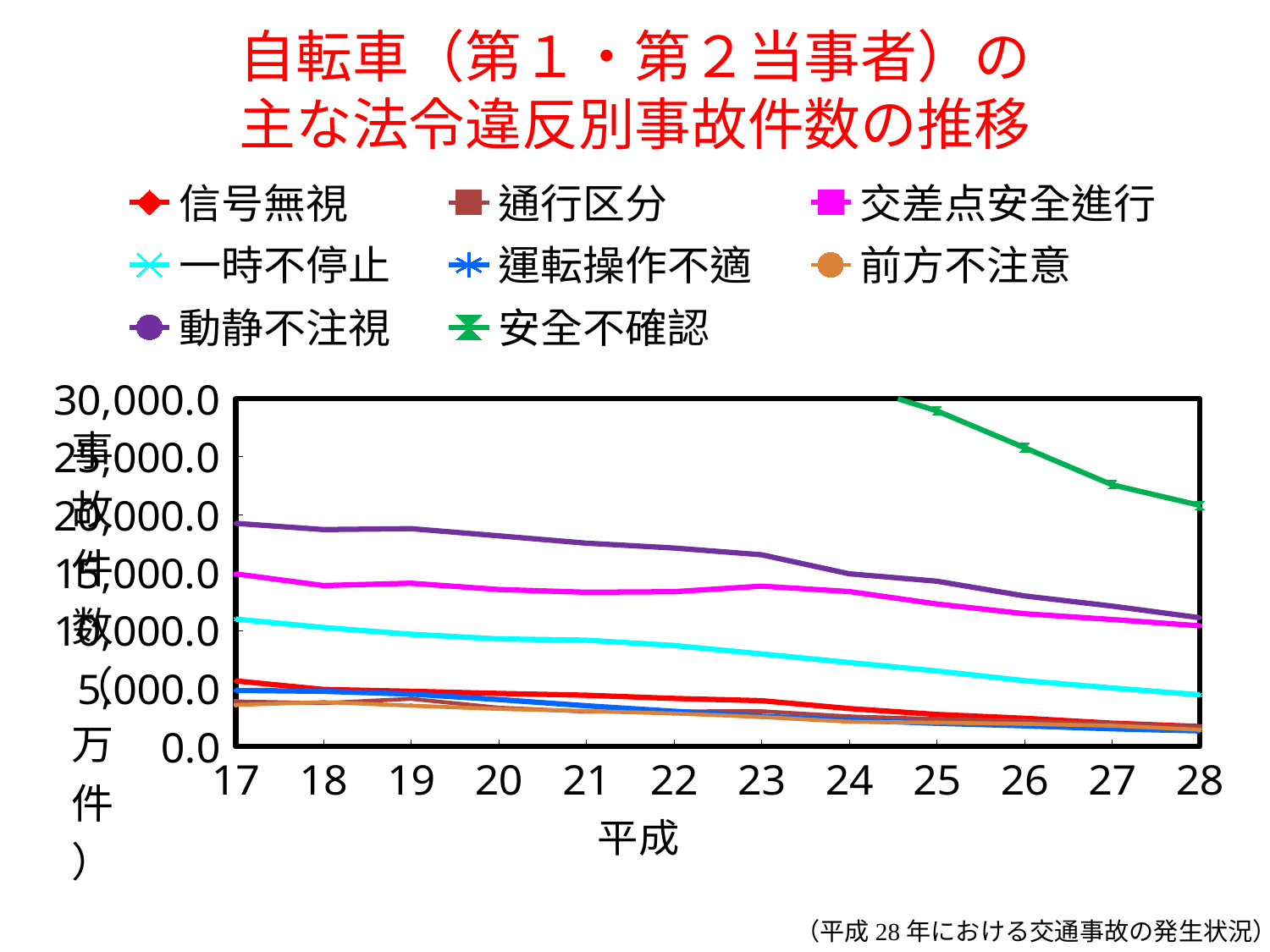
Which is larger in 平成28, 交差点安全進行 or 信号無視? 交差点安全進行 How many series does the legend list? 8 Is the value for 動静不注視 in 平成17 greater or less than 20,000.0? less Is the value for 一時不停止 in 平成28 greater or less than 5,000.0? less Is the value for 一時不停止 in 平成17 greater or less than 10,000.0? greater Which is larger in 平成17, 動静不注視 or 一時不停止? 動静不注視 Which series has the highest value in 平成28? 安全不確認 Does the value for 一時不停止 rise or fall from 平成17 to 平成28? fall How many years (points) are shown along the x axis? 12 What is the label of the x axis? 平成 What kind of chart is shown on the slide? line chart